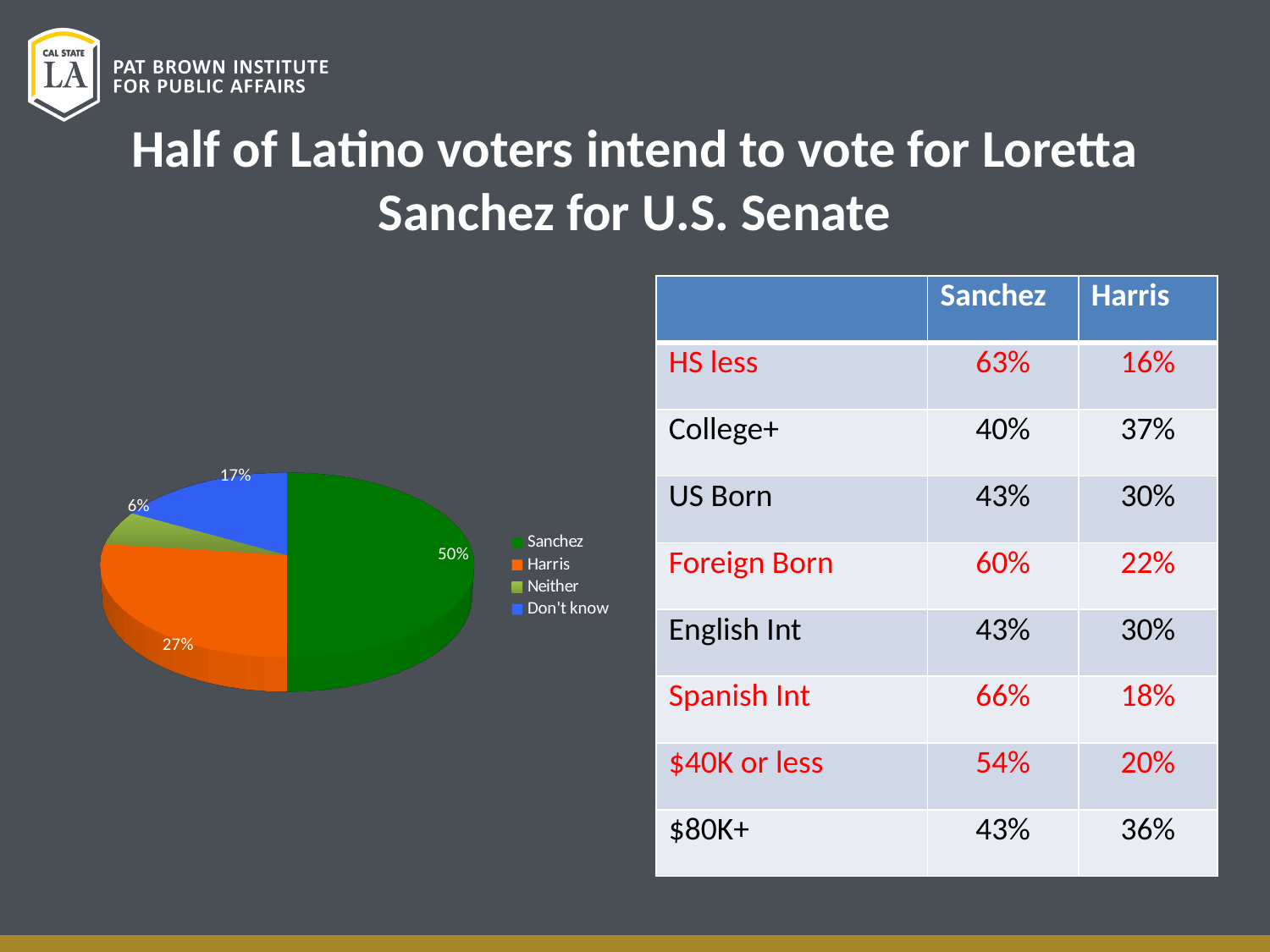
What is the difference in percentage points between the Sanchez slice and the Harris slice? 23 Which slice of the pie is the smallest? Neither What share of the pie does Sanchez have? 50% How many entries does the pie chart's legend list? 4 What share of the pie is labelled Don't know? 17% What share of the pie is labelled Neither? 6% What colour is the Sanchez slice in the pie chart? green Which is larger, the Don't know slice or the Harris slice? Harris What kind of chart is shown on the slide? pie chart What share of the pie does Harris have? 27% How many slices does the pie chart have? 4 Which slice of the pie is the largest? Sanchez